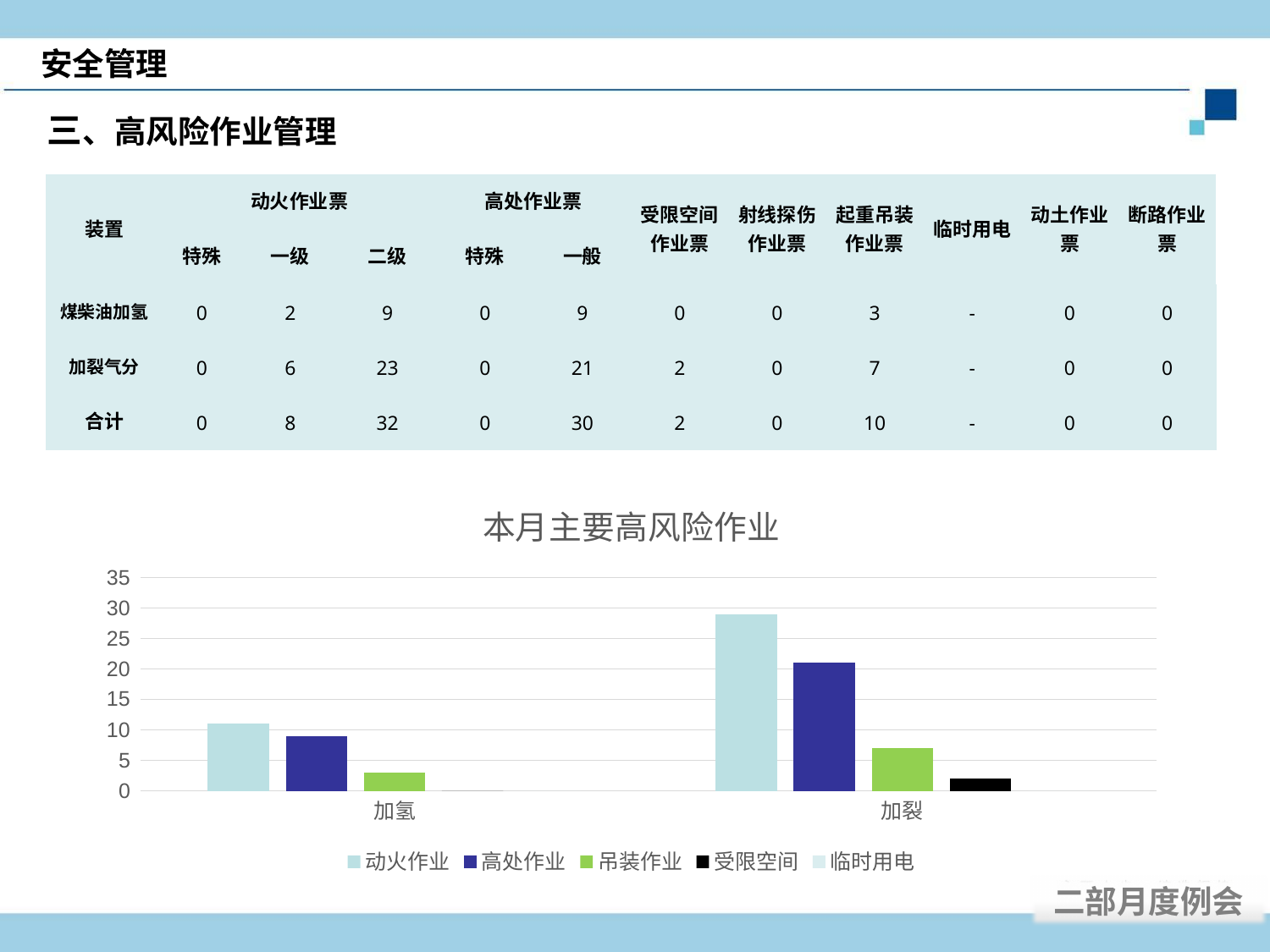
What kind of chart is shown on the slide? bar chart What is the title of the chart? 本月主要高风险作业 Is the value of 动火作业 for 加裂 greater or less than 25? greater Is the value of 吊装作业 for 加裂 greater or less than 5? greater How many categories are shown on the x axis of the chart? 2 Which series has the highest value for 加裂? 动火作业 Which is larger, 动火作业 for 加氢 or 动火作业 for 加裂? 动火作业 for 加裂 Which is larger, 吊装作业 for 加氢 or 高处作业 for 加氢? 高处作业 for 加氢 Which series has the highest value for 加氢? 动火作业 Is the value of 高处作业 for 加裂 greater or less than 20? greater How many series does the chart legend list? 5